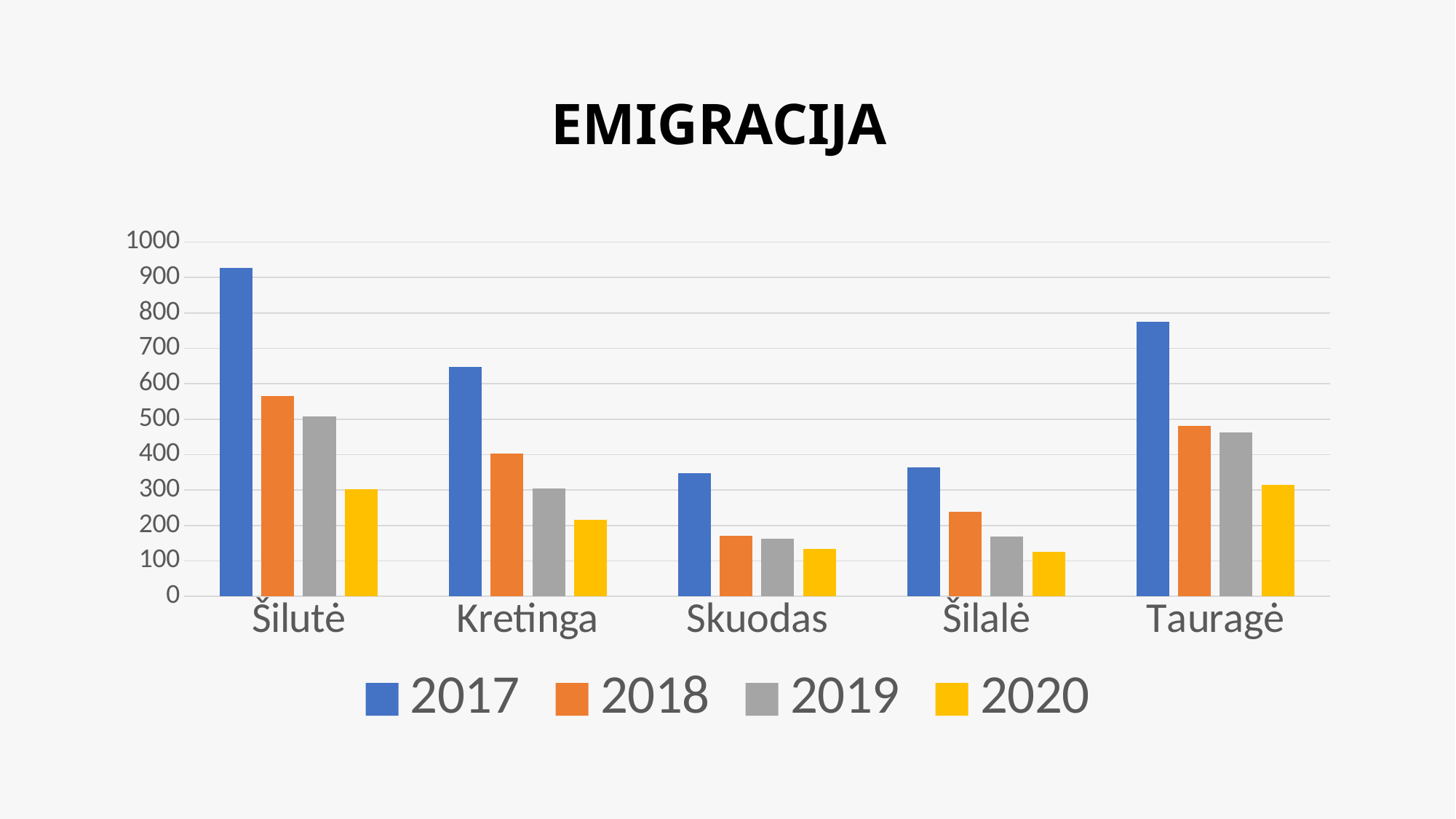
Which category has the highest value for 2018? Šilutė What is the title of the chart? EMIGRACIJA Which is larger: the 2018 value for Kretinga or the 2018 value for Tauragė? Tauragė How many series does the legend list? 4 Is the value for Šilutė in 2017 greater or less than 800? greater Is the value for Tauragė in 2017 greater or less than 800? less For Šilutė, do the values rise or fall from 2017 to 2020? fall Is the value for Kretinga in 2017 greater or less than 600? greater How many categories are shown on the x axis? 5 Which category has the highest value for 2017? Šilutė What kind of chart is shown on the slide? bar chart